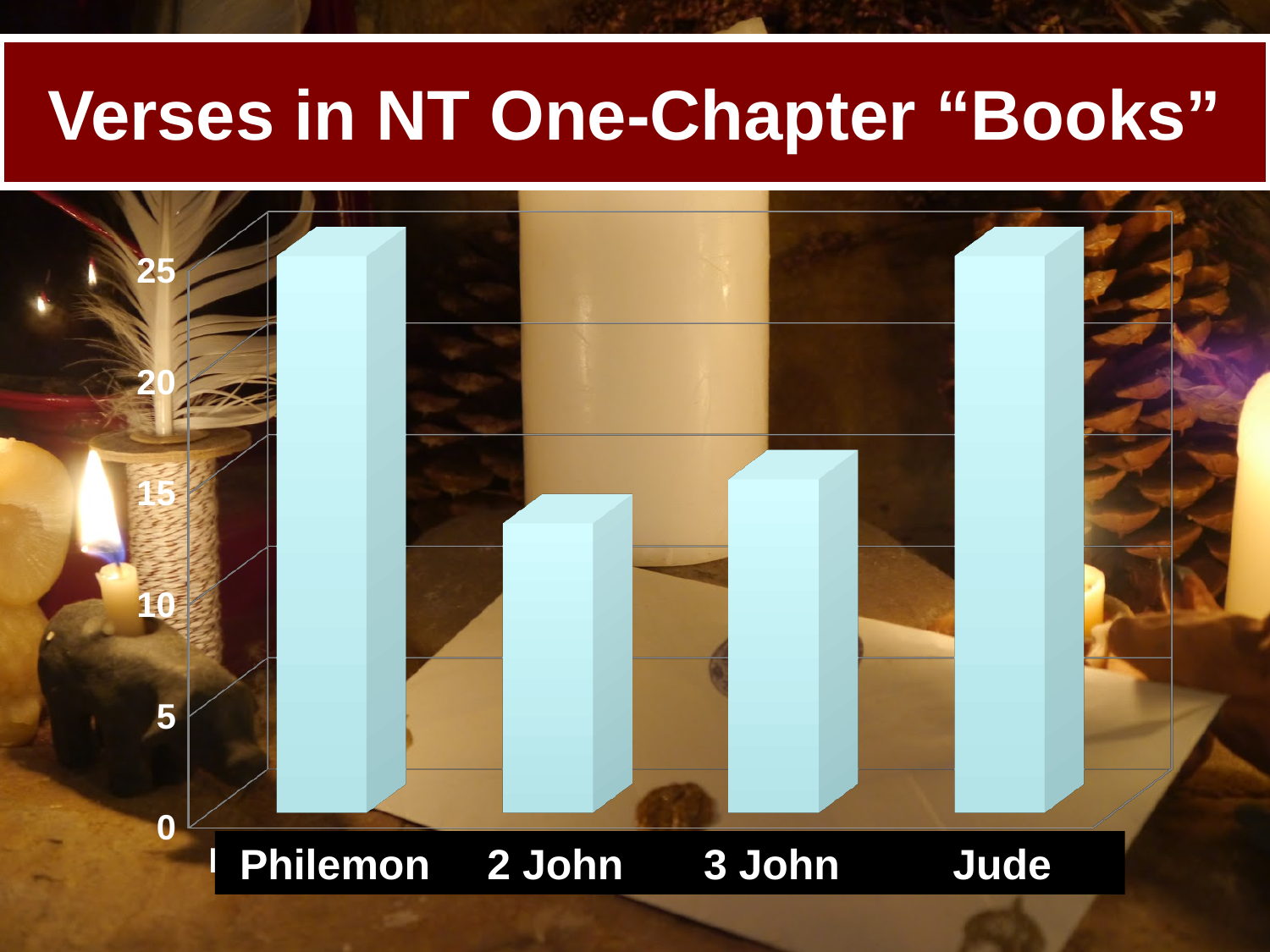
Is the value for 2 John greater or less than 10? greater What kind of chart is shown on the slide? bar chart Is the value for 3 John greater or less than 10? greater How many books are shown on the x axis of the chart? 4 Which book has the lowest bar in the chart? 2 John Is the value for Jude greater or less than 20? greater Which has the larger value, 2 John or 3 John? 3 John Which has the larger value, Jude or 3 John? Jude What is the title of the chart? Verses in NT One-Chapter "Books"